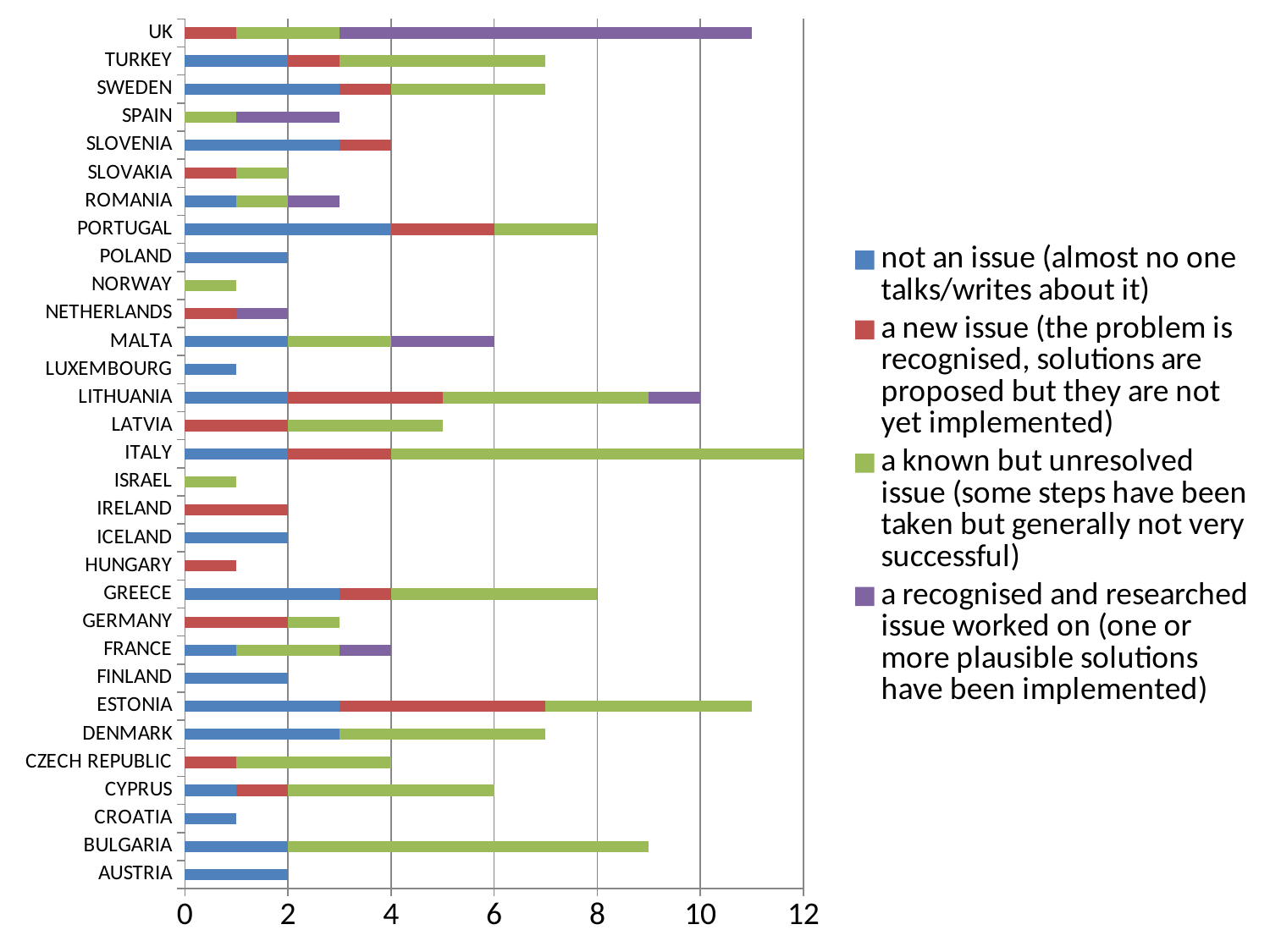
What is the total length of the stacked bar for Italy? 12 Which has the longer total bar, Estonia or Denmark? Estonia What colour represents the series 'not an issue (almost no one talks/writes about it)'? blue Which country has the longest total bar? Italy How many countries are shown on the vertical axis? 31 Is the total bar for Portugal greater or less than 6? greater Is the total bar for Spain greater or less than 4? less How many series does the legend list? 4 What kind of chart is shown on the slide? stacked bar chart Which has the longer total bar, UK or Greece? UK What is the total length of the stacked bar for Lithuania? 10